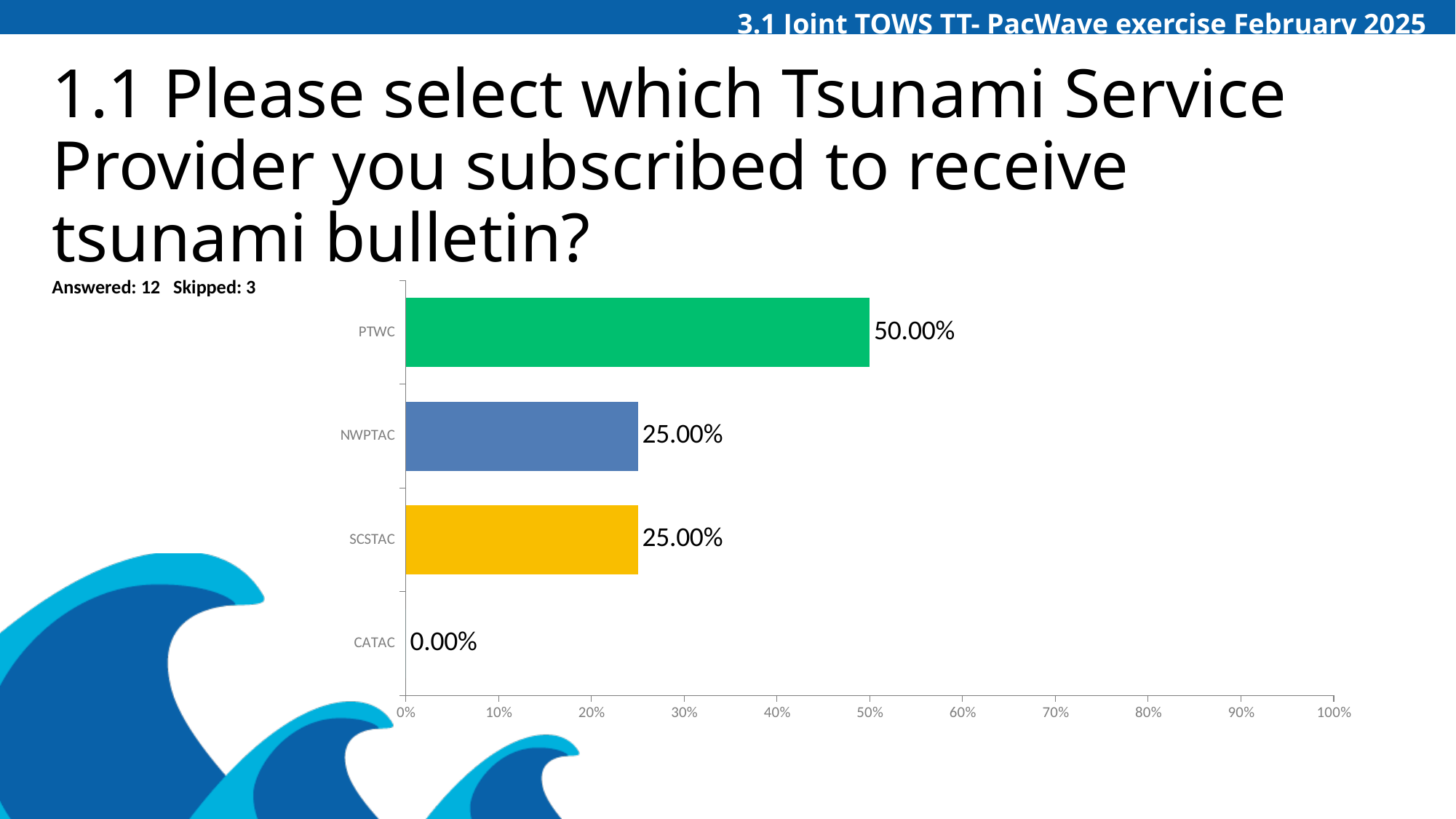
Which has a larger percentage, PTWC or NWPTAC? PTWC What percentage of respondents subscribed to NWPTAC? 25.00% How many respondents answered the question according to the slide? 12 Which Tsunami Service Provider has the lowest percentage? CATAC What percentage of respondents subscribed to CATAC? 0.00% What is the difference in percentage between PTWC and SCSTAC? 25.00% Which Tsunami Service Provider has the highest percentage? PTWC What kind of chart is shown on the slide? Bar chart What percentage of respondents subscribed to PTWC? 50.00% How many Tsunami Service Providers are shown in the chart? 4 Is the value for PTWC greater or less than 40%? greater What colour is the bar for SCSTAC? Yellow